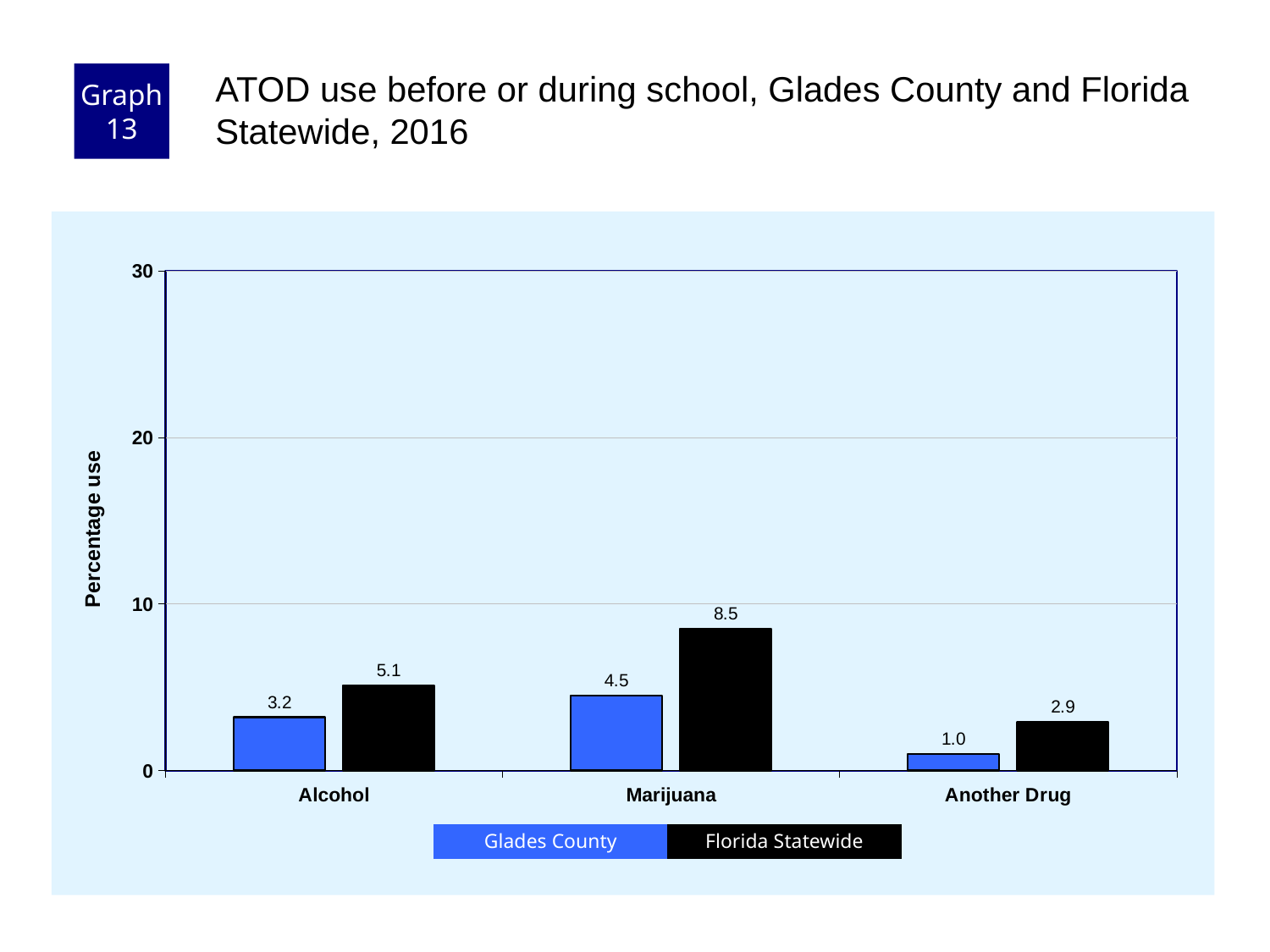
Is the Florida Statewide value for Marijuana greater or less than 10? less What kind of chart is shown on the slide? bar chart Which category has the lowest Glades County value? Another Drug How many categories are shown on the x axis? 3 What is the Glades County value for Another Drug? 1.0 For Alcohol, which is larger: the Glades County value or the Florida Statewide value? Florida Statewide What is the Glades County value for Alcohol? 3.2 What is the difference between the Florida Statewide and Glades County values for Marijuana? 4.0 What is the Florida Statewide value for Marijuana? 8.5 Which category has the highest Florida Statewide value? Marijuana What is the Florida Statewide value for Another Drug? 2.9 How many series does the legend list? 2